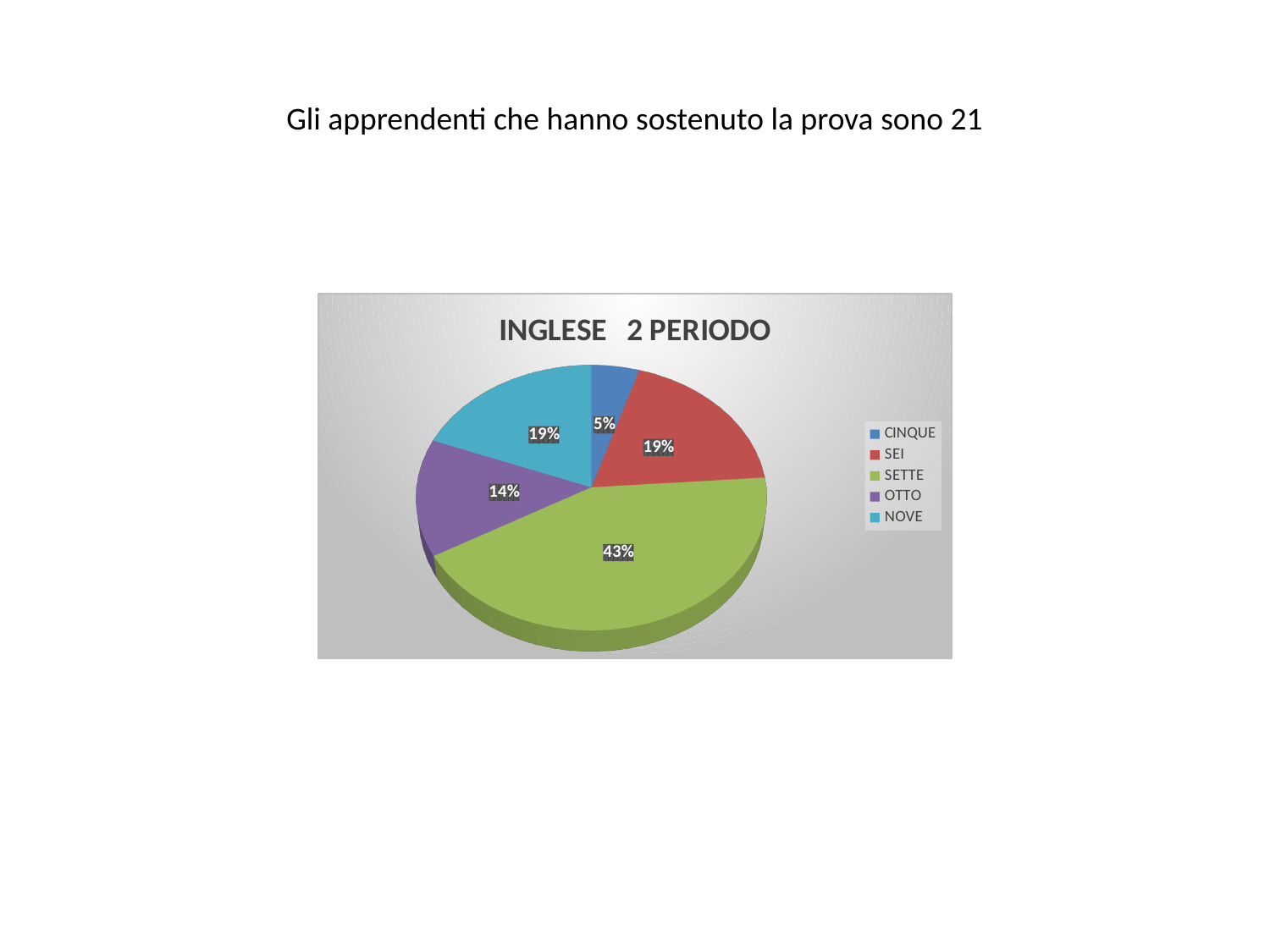
What is the title of the chart? INGLESE 2 PERIODO What kind of chart is shown on the slide? Pie chart What share of the pie does SETTE represent? 43% Which colour represents SETTE in the pie chart? Green Which category has the largest slice of the pie? SETTE What share of the pie does OTTO represent? 14% How many categories does the pie chart show? 5 Which category has the smallest slice of the pie? CINQUE What share of the pie does SEI represent? 19% Which slice is larger, OTTO or NOVE? NOVE What is the difference in percentage points between the SETTE slice and the OTTO slice? 29